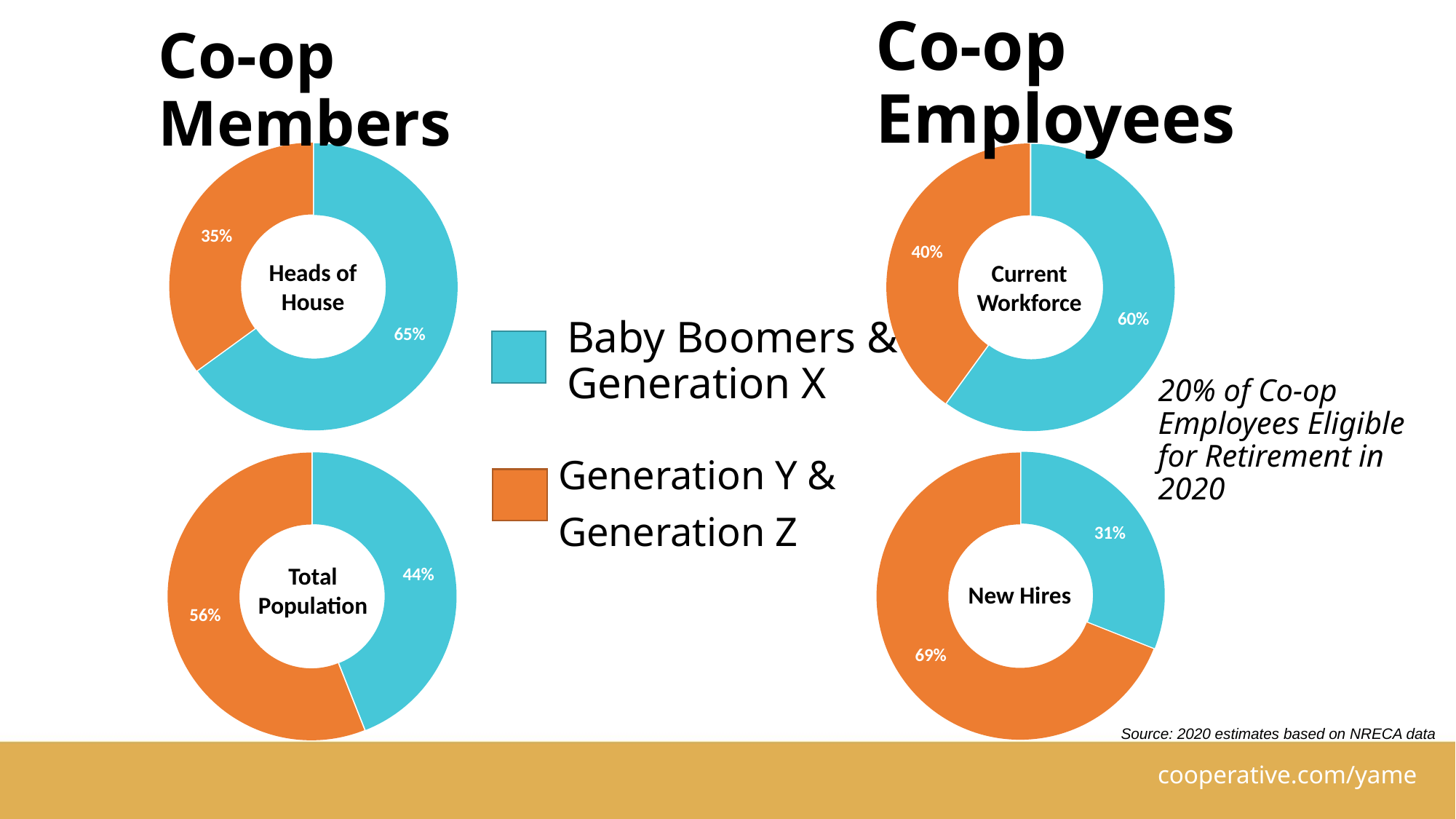
In the "Current Workforce" chart, what is the difference between the Baby Boomers & Generation X share and the Generation Y & Generation Z share? 20% In the "Total Population" chart, which group has the smaller share? Baby Boomers & Generation X How many groups does the legend list? 2 In the "Total Population" chart, what share is Generation Y & Generation Z? 56% In the "New Hires" chart, which group has the larger share? Generation Y & Generation Z Is the Baby Boomers & Generation X share larger in the "Heads of House" chart or the "Current Workforce" chart? Heads of House In the "New Hires" chart, what share is Generation Y & Generation Z? 69% What kind of chart is the "New Hires" chart? Donut (pie) chart Which colour represents Generation Y & Generation Z in the charts? Orange In the "Heads of House" chart, what share is Generation Y & Generation Z? 35% In the "Current Workforce" chart, what share is Baby Boomers & Generation X? 60% In the "Heads of House" chart, what share is Baby Boomers & Generation X? 65%